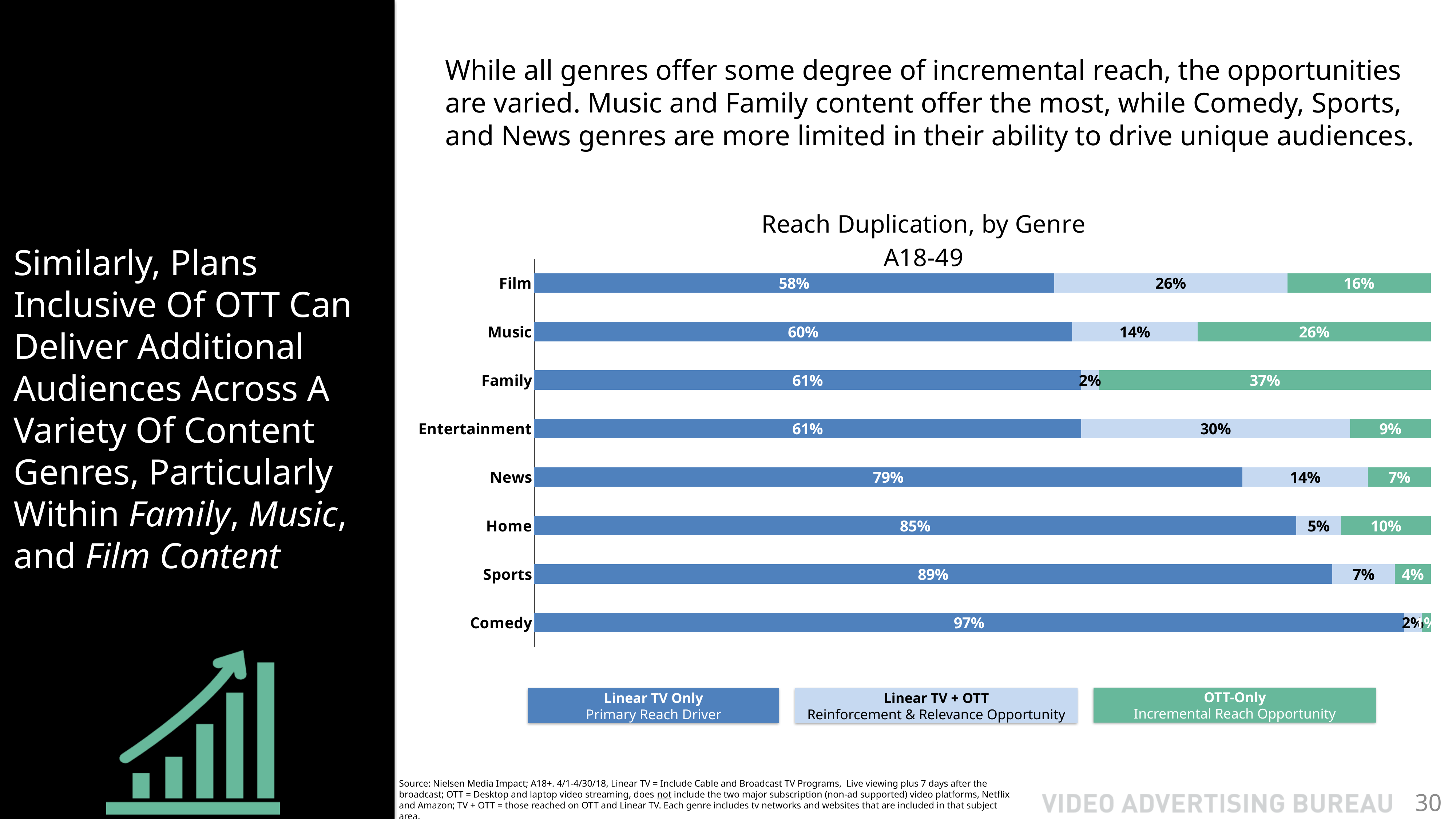
What is the OTT-Only value for Family? 37% What is the Linear TV + OTT value for Entertainment? 30% Which genre has the highest OTT-Only value? Family How many genres are shown in the chart? 8 Which has a larger Linear TV + OTT value, Film or Music? Film What is the total of the stacked bar for Film? 100% What is the difference between the OTT-Only values for Family and Music? 11% What is the Linear TV Only value for News? 79% What is the title of the chart? Reach Duplication, by Genre A18-49 Which genre has the lowest Linear TV Only value? Film How many series does the legend list? 3 What kind of chart is shown on the slide? Stacked bar chart